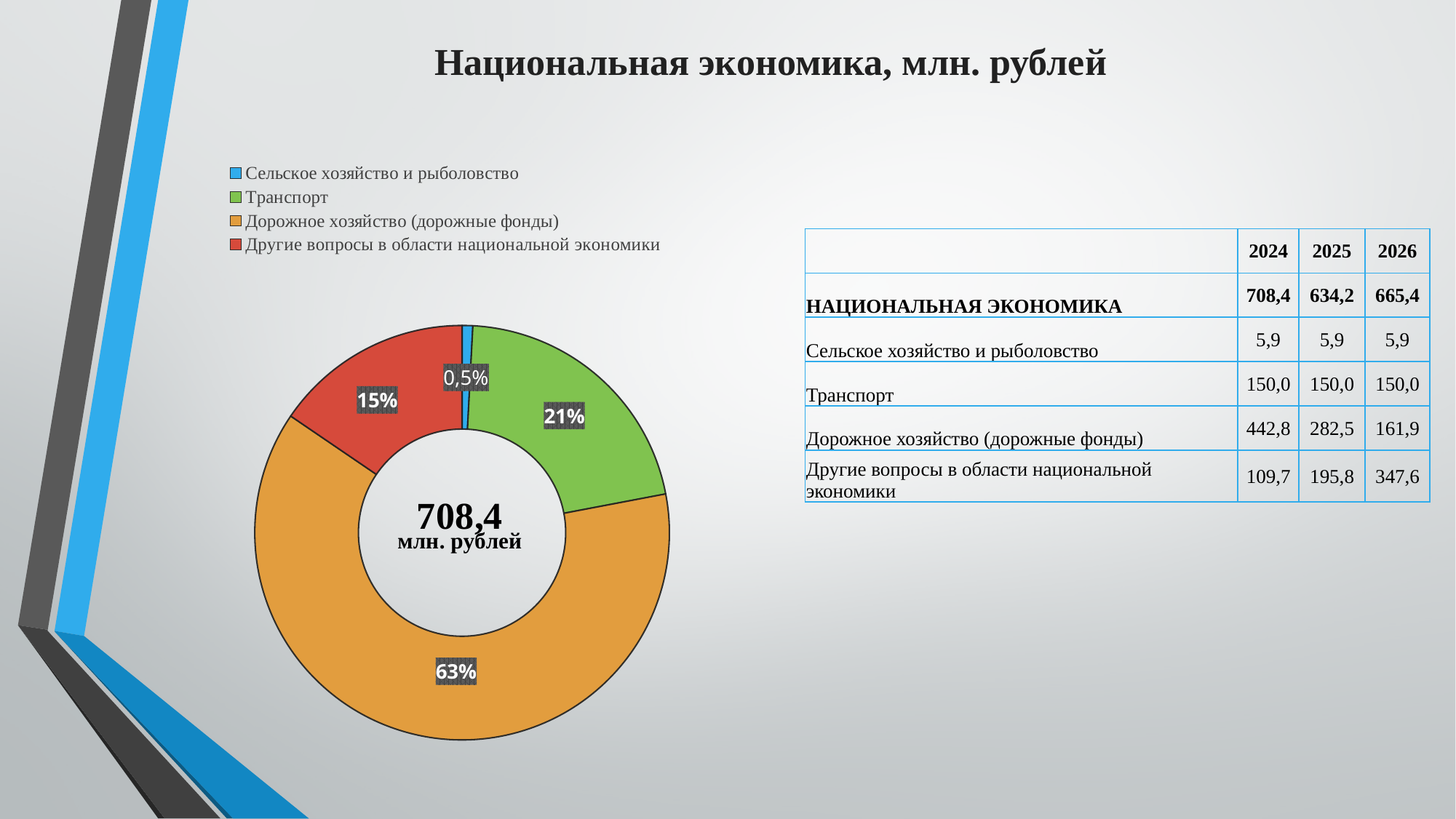
What percentage is shown for Другие вопросы в области национальной экономики on the doughnut chart? 15% What percentage is shown for Транспорт on the doughnut chart? 21% What total value is printed in the centre of the doughnut chart? 708,4 млн. рублей What share of the doughnut chart does Дорожное хозяйство (дорожные фонды) take? 63% Which category has the smallest slice of the doughnut chart? Сельское хозяйство и рыболовство What percentage is shown for Сельское хозяйство и рыболовство on the doughnut chart? 0,5% What kind of chart is shown on the slide? Doughnut (pie) chart What colour is the Транспорт slice in the doughnut chart? Green Which category has the largest slice of the doughnut chart? Дорожное хозяйство (дорожные фонды) How many categories are shown in the doughnut chart? 4 By how many percentage points does the Дорожное хозяйство slice exceed the Транспорт slice? 42% Which slice is larger: Транспорт or Другие вопросы в области национальной экономики? Транспорт